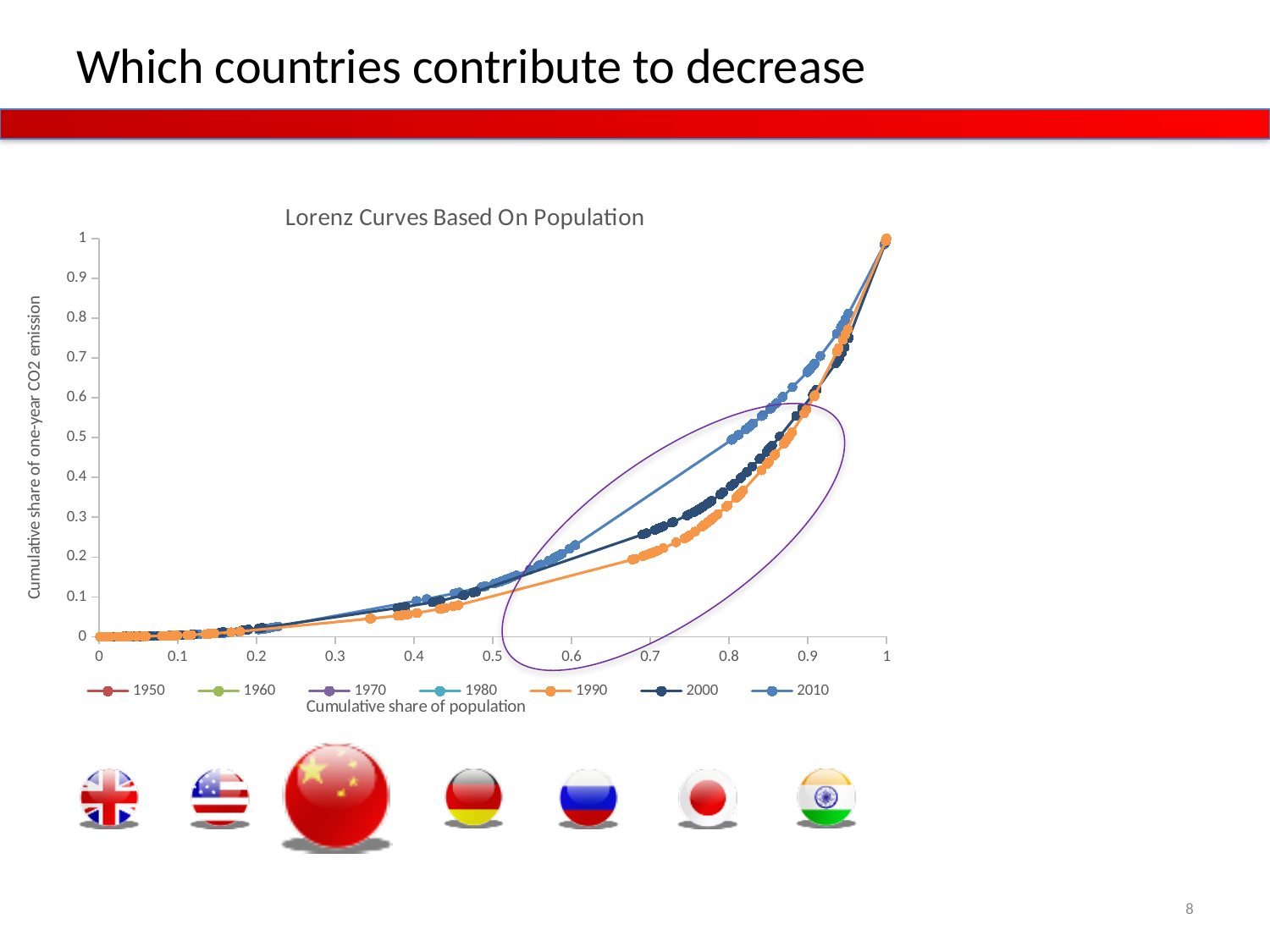
What is the cumulative share of CO2 emission when the cumulative share of population is 0? 0 What is the cumulative share of CO2 emission when the cumulative share of population is 1? 1 At a cumulative share of population of 0.7, which series has the higher value, 2010 or 1990? 2010 What is the label of the x axis? Cumulative share of population At a cumulative share of population of 0.7, is the value for the 1990 series greater or less than 0.3? less What is the title of the chart? Lorenz Curves Based On Population At a cumulative share of population of 0.7, is the value for the 2010 series greater or less than 0.3? greater Do the curves rise or fall as the cumulative share of population increases? rise At a cumulative share of population of 0.8, is the value for the 2010 series greater or less than 0.4? greater How many series does the legend list? 7 What kind of chart is shown on the slide? line chart